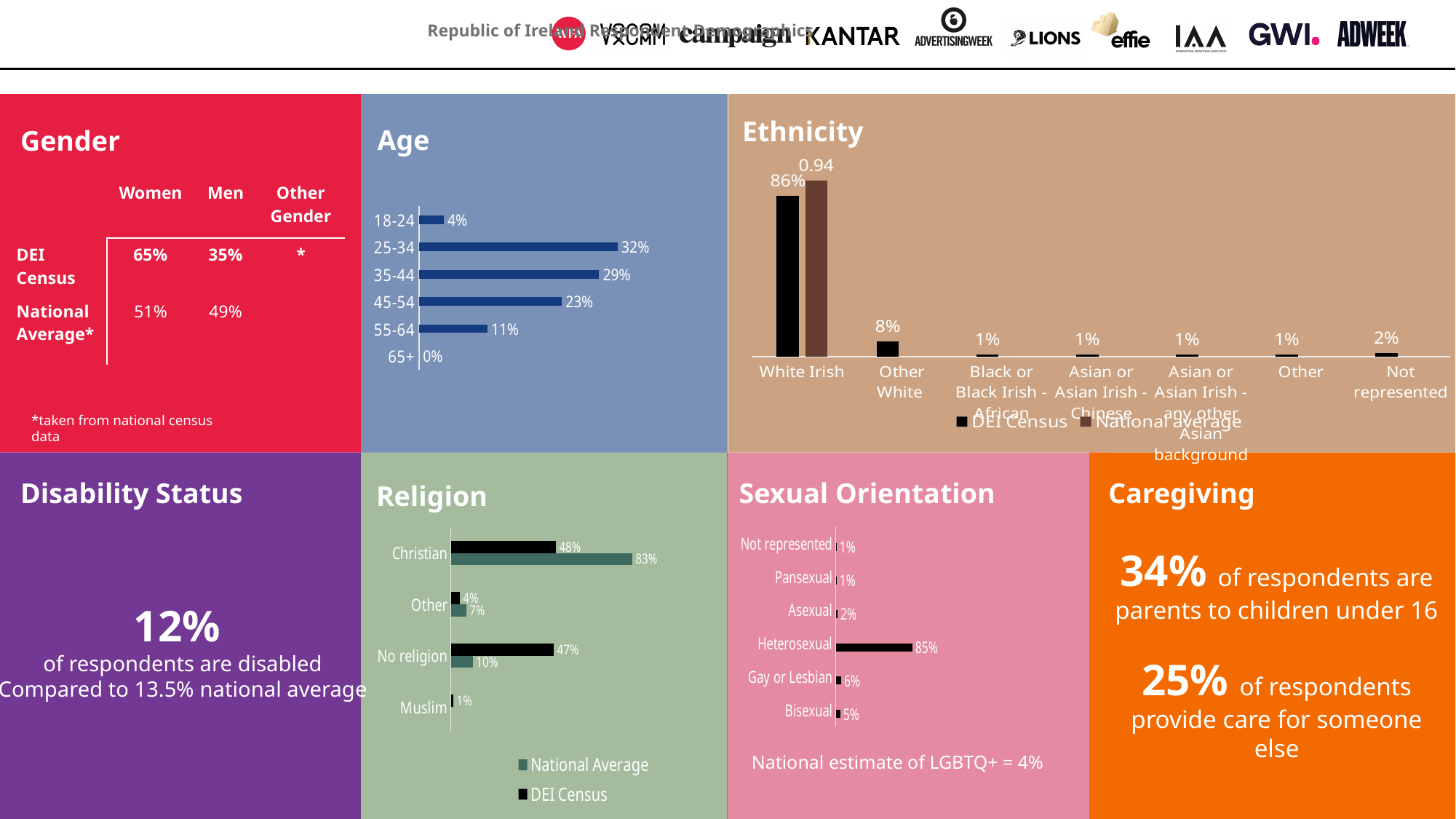
How many age groups are shown in the Age chart? 6 In the Ethnicity chart, what is the DEI Census value for White Irish? 86% What kind of chart is the Sexual Orientation chart? Bar chart In the Age chart, what is the difference between the 35-44 and 45-54 percentages? 6% How many series does the legend of the Ethnicity chart list? 2 In the Religion chart, which is larger for No religion: the DEI Census value or the National Average value? DEI Census In the Religion chart, what is the difference between the DEI Census and National Average values for Other? 3% In the Age chart, which age group has the highest percentage? 25-34 In the Religion chart, what is the National Average value for Christian? 83% In the Sexual Orientation chart, what percentage of respondents are Heterosexual? 85% In the Ethnicity chart, what is the DEI Census value for Not represented? 2% In the Age chart, what percentage of respondents are aged 25-34? 32%